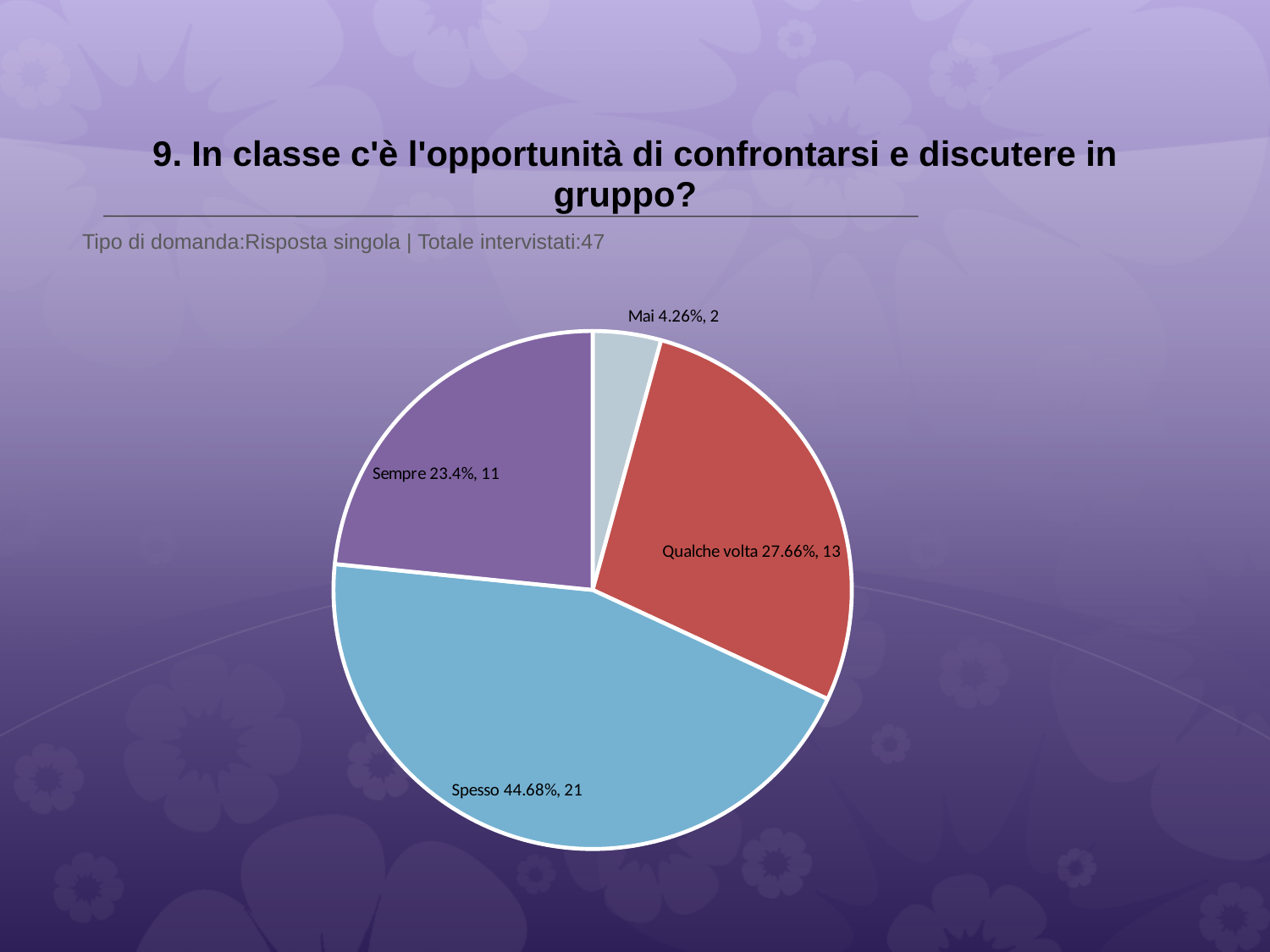
Which category has the smallest slice? Mai How many respondents answered 'Mai'? 2 What is the total number of respondents shown in the subtitle? 47 What percentage share does the 'Spesso' slice have? 44.68% What is the difference in number of respondents between 'Spesso' and 'Sempre'? 10 How many respondents answered 'Qualche volta'? 13 Which category has the largest slice? Spesso Which has more respondents, 'Qualche volta' or 'Sempre'? Qualche volta What colour is the 'Spesso' slice? light blue How many slices does the pie chart have? 4 What percentage share does the 'Sempre' slice have? 23.4% What kind of chart is shown on the slide? pie chart